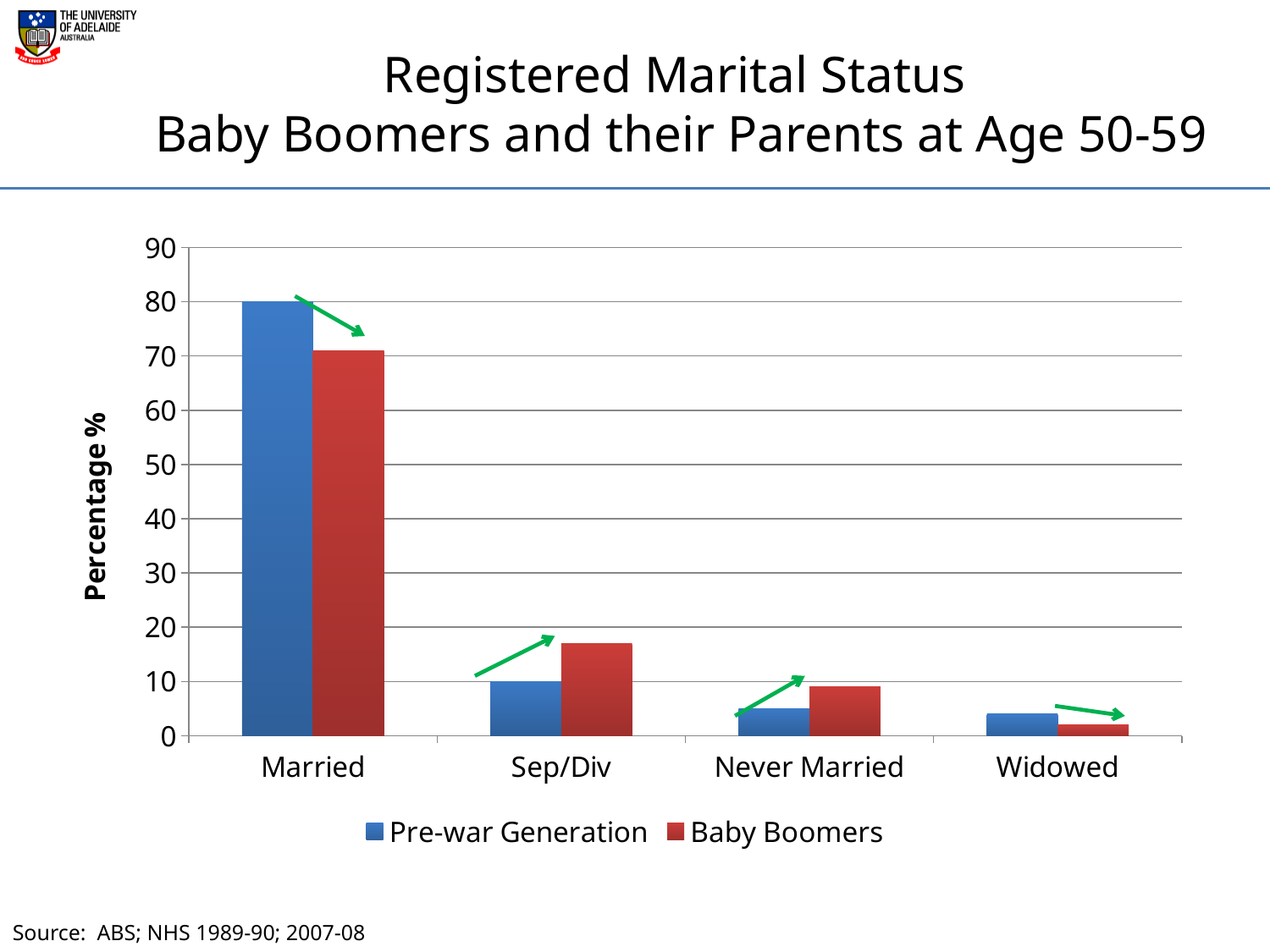
Is the value for Baby Boomers in the Sep/Div category greater or less than 10? greater In the Married category, which series has the larger value, Pre-war Generation or Baby Boomers? Pre-war Generation How many marital status categories are shown on the x axis? 4 How many series does the legend list? 2 What is the label on the vertical axis? Percentage % What type of chart is shown on the slide? Bar chart In the Sep/Div category, which series has the larger value, Pre-war Generation or Baby Boomers? Baby Boomers Which category has the highest value for the Pre-war Generation? Married Which category has the lowest value for Baby Boomers? Widowed Is the value for Baby Boomers in the Married category greater or less than 80? less What is the value for the Pre-war Generation in the Sep/Div category? 10 What is the value for the Pre-war Generation in the Married category? 80